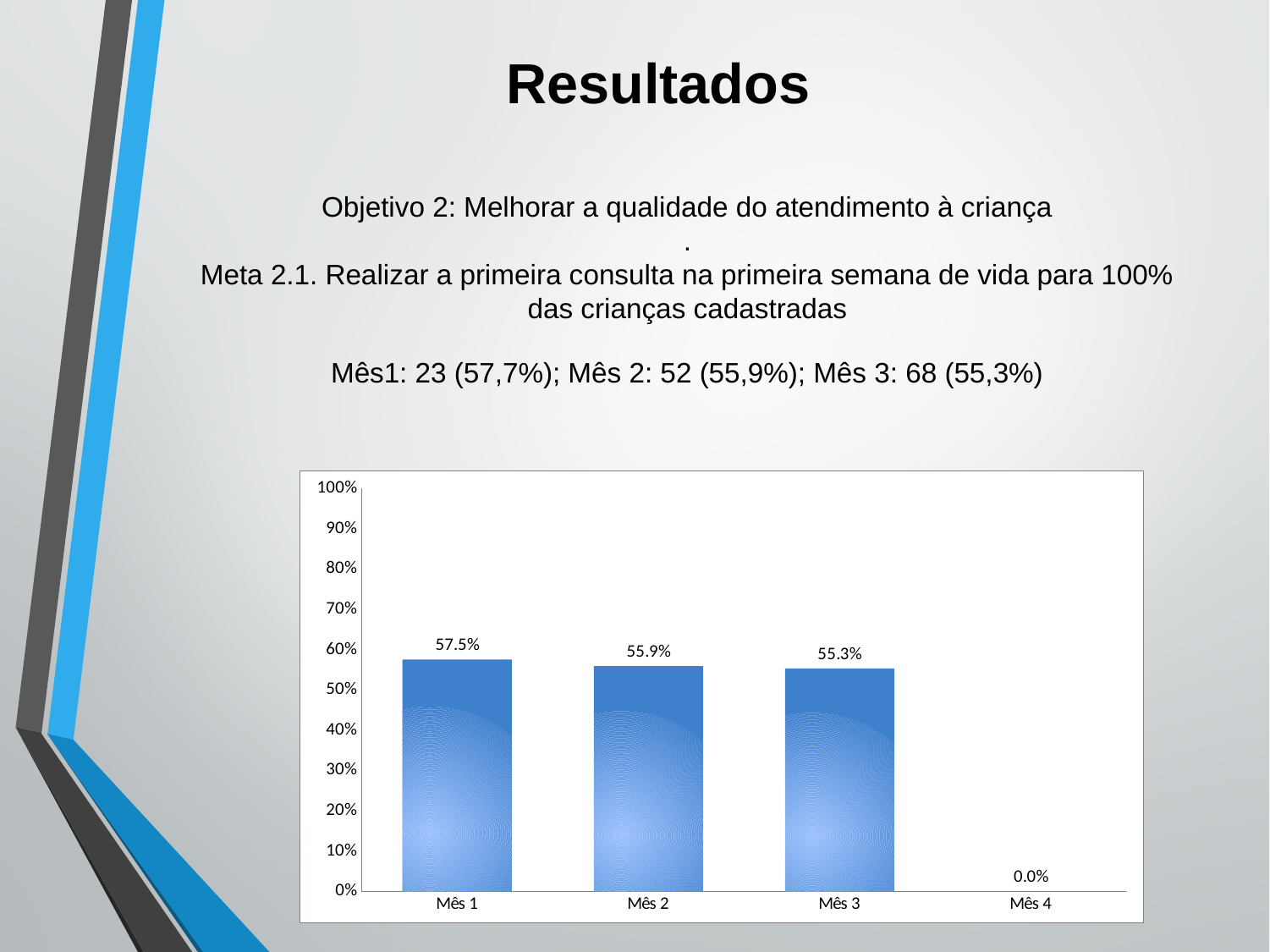
Which month has the lowest value in the chart? Mês 4 What is the value shown for Mês 3? 55.3% What is the value shown for Mês 4? 0.0% What is the difference between the values for Mês 2 and Mês 3? 0.6% What is the value shown for Mês 1? 57.5% Which is larger, the value for Mês 1 or the value for Mês 2? Mês 1 What kind of chart is shown on the slide? bar chart What is the difference between the values for Mês 1 and Mês 3? 2.2% Which month has the highest value in the chart? Mês 1 Is the value for Mês 3 greater or less than 60%? less What is the value shown for Mês 2? 55.9% How many months are shown on the x axis of the chart? 4